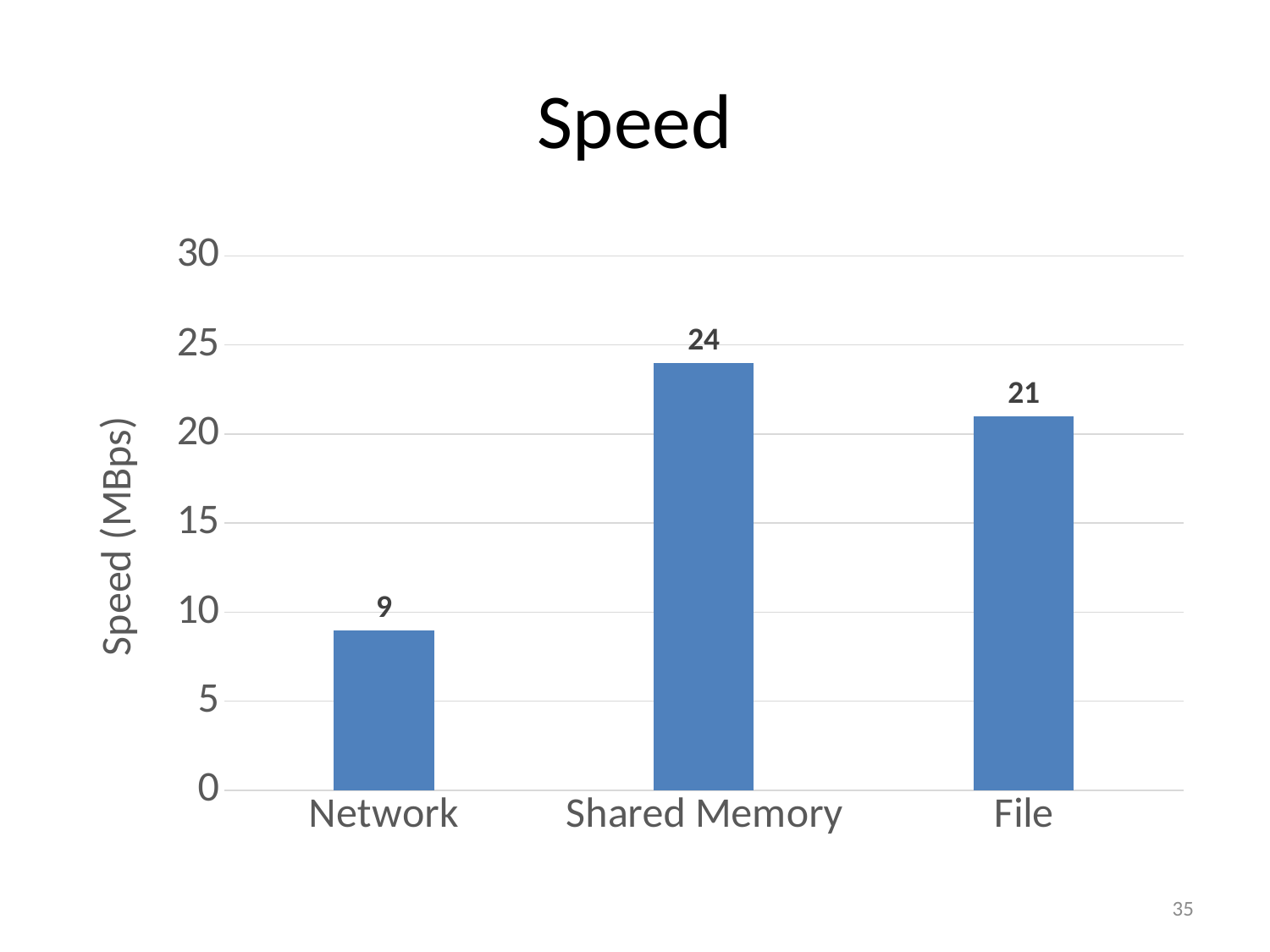
Which category has the highest speed? Shared Memory Is the value for File greater or less than 20? greater What is the speed value for Shared Memory? 24 What is the speed value for Network? 9 What is the speed value for File? 21 What is the difference between the speed for Shared Memory and the speed for Network? 15 What is the label of the y axis? Speed (MBps) How many categories are shown on the x axis? 3 What is the difference between the speed for Shared Memory and the speed for File? 3 Which has a higher speed, File or Network? File Which category has the lowest speed? Network What kind of chart is shown on the slide? bar chart